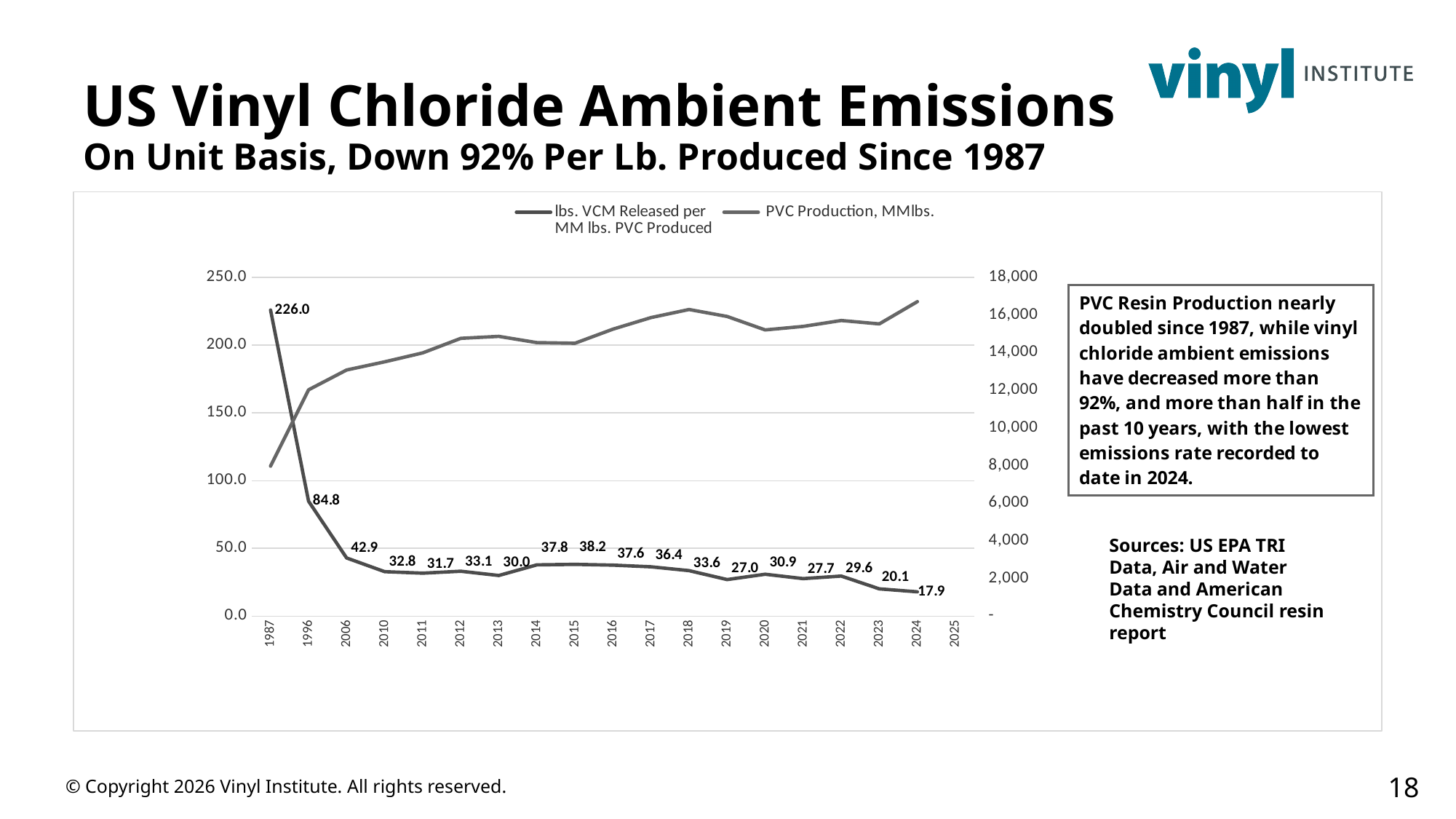
Does the PVC Production, MMlbs. series generally rise or fall from 1987 to 2024? Rise How many series does the legend list? 2 What kind of chart is shown on the slide? Line chart What is the value of lbs. VCM Released per MM lbs. PVC Produced in 1987? 226.0 What is the value of lbs. VCM Released per MM lbs. PVC Produced in 2015? 38.2 What is the value of lbs. VCM Released per MM lbs. PVC Produced in 2024? 17.9 In which year is lbs. VCM Released per MM lbs. PVC Produced the lowest? 2024 What is the difference between the lbs. VCM Released per MM lbs. PVC Produced values for 1987 and 1996? 141.2 Which year has a higher value of lbs. VCM Released per MM lbs. PVC Produced, 2019 or 2020? 2020 In which year is lbs. VCM Released per MM lbs. PVC Produced the highest? 1987 Is the PVC Production, MMlbs. value for 2024 greater or less than 16,000? greater Is the PVC Production, MMlbs. value for 2006 greater or less than 12,000? greater